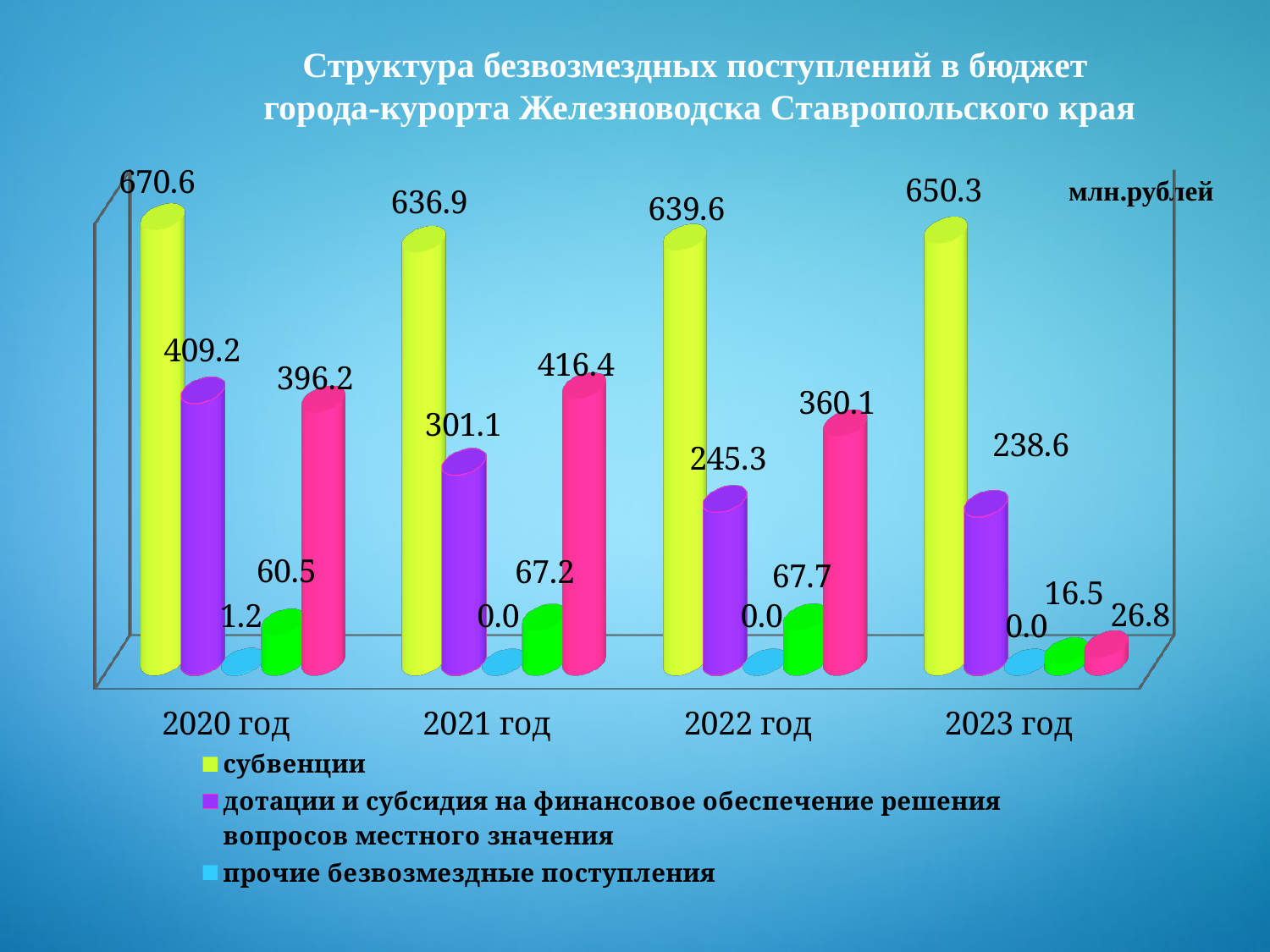
What is the value of субвенции for 2020 год? 670.6 Which year has the larger value of субвенции, 2022 год or 2023 год? 2023 год What is the value of дотации и субсидия на финансовое обеспечение решения вопросов местного значения for 2023 год? 238.6 In which year is the value of дотации и субсидия на финансовое обеспечение решения вопросов местного значения the lowest? 2023 год In which year is the value of субвенции the highest? 2020 год What kind of chart is shown on the slide? bar chart How many series does the legend list? 3 Do the values of дотации и субсидия на финансовое обеспечение решения вопросов местного значения rise or fall from 2020 год to 2023 год? fall How many year categories are shown on the x axis? 4 What is the difference between the субвенции values for 2020 год and 2021 год? 33.7 What is the value of прочие безвозмездные поступления for 2020 год? 1.2 What is the difference between the дотации и субсидия values for 2020 год and 2021 год? 108.1